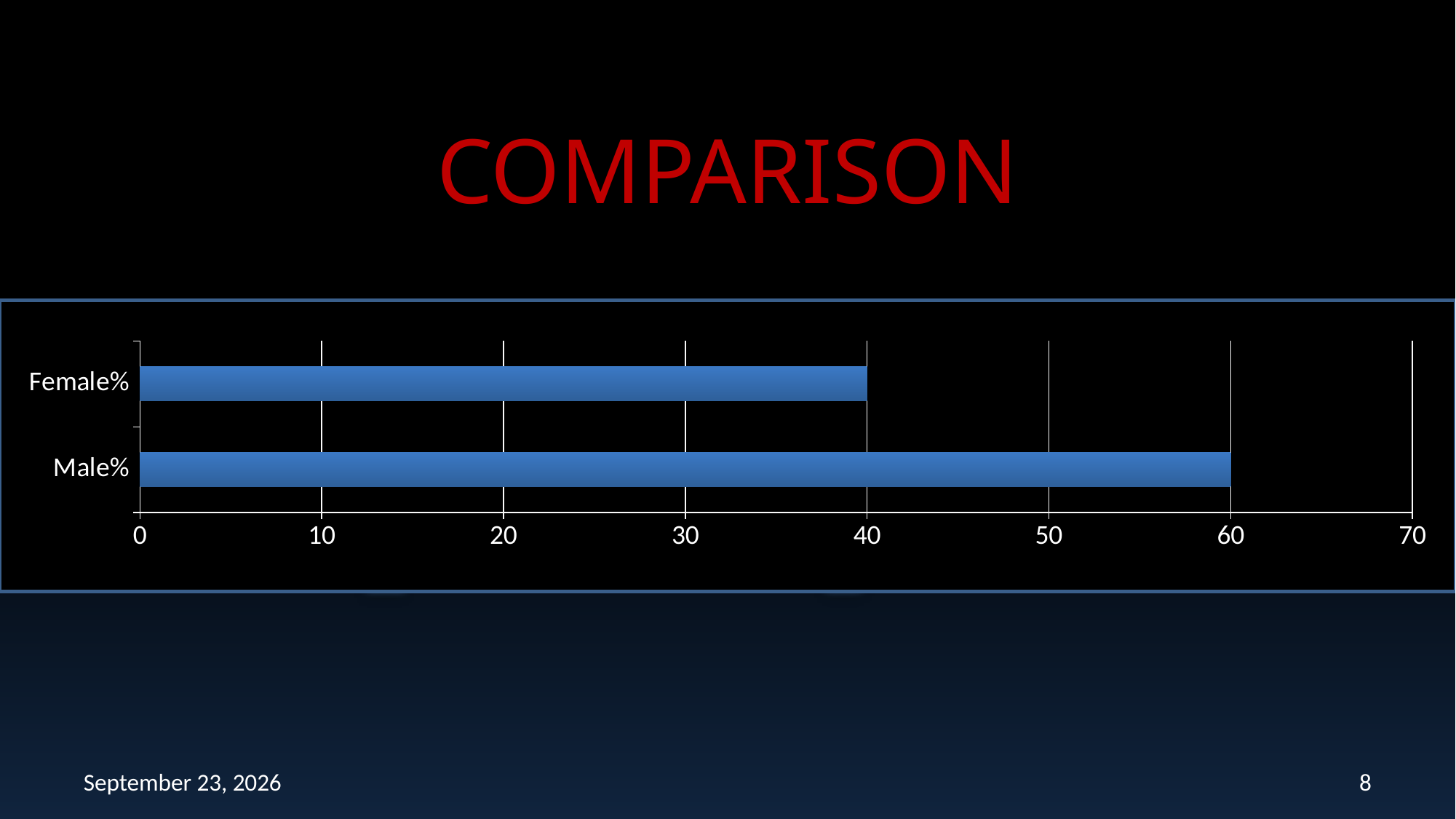
Which category has the highest value? Male% Which category has the lowest value? Female% What is the title of the slide containing the chart? COMPARISON What is the value for Male%? 60 What kind of chart is shown on the slide? bar chart Is the value for Female% greater or less than 50? less What is the value for Female%? 40 What is the maximum value shown on the horizontal axis? 70 Which is larger, the value for Male% or the value for Female%? Male% What is the difference between the values for Male% and Female%? 20 Is the value for Male% greater or less than 50? greater How many categories are shown in the chart? 2